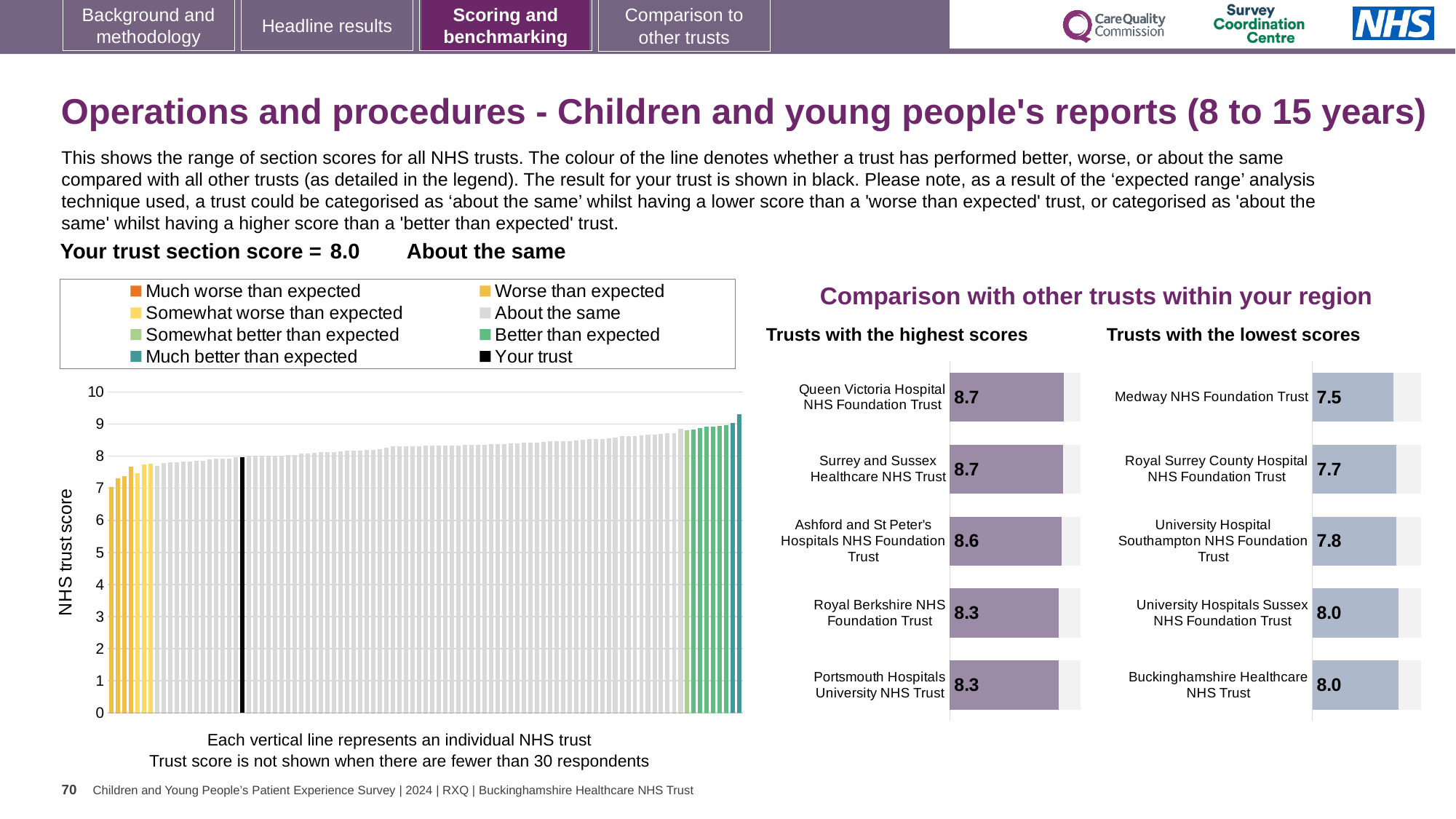
In the 'Trusts with the lowest scores' chart, what is the score for University Hospital Southampton NHS Foundation Trust? 7.8 In the 'Trusts with the highest scores' chart, which has the higher score: Ashford and St Peter's Hospitals NHS Foundation Trust or Royal Berkshire NHS Foundation Trust? Ashford and St Peter's Hospitals NHS Foundation Trust In the main chart on the left, do the trust scores rise or fall from left to right? rise In the 'Trusts with the highest scores' chart, what is the difference between the scores of Queen Victoria Hospital NHS Foundation Trust and Portsmouth Hospitals University NHS Trust? 0.4 What kind of chart is the main chart on the left showing NHS trust scores? bar chart In the 'Trusts with the highest scores' chart, what is the score for Ashford and St Peter's Hospitals NHS Foundation Trust? 8.6 In the 'Trusts with the lowest scores' chart, what is the difference between the scores of Buckinghamshire Healthcare NHS Trust and Medway NHS Foundation Trust? 0.5 How many entries does the legend above the main chart on the left list? 8 In the main chart on the left, what is the score for your trust (the black bar)? 8.0 In the main chart on the left, is the value of the leftmost bar greater or less than 8? less In the 'Trusts with the lowest scores' chart, which trust has the lowest score? Medway NHS Foundation Trust In the 'Trusts with the highest scores' chart, how many trusts are shown? 5